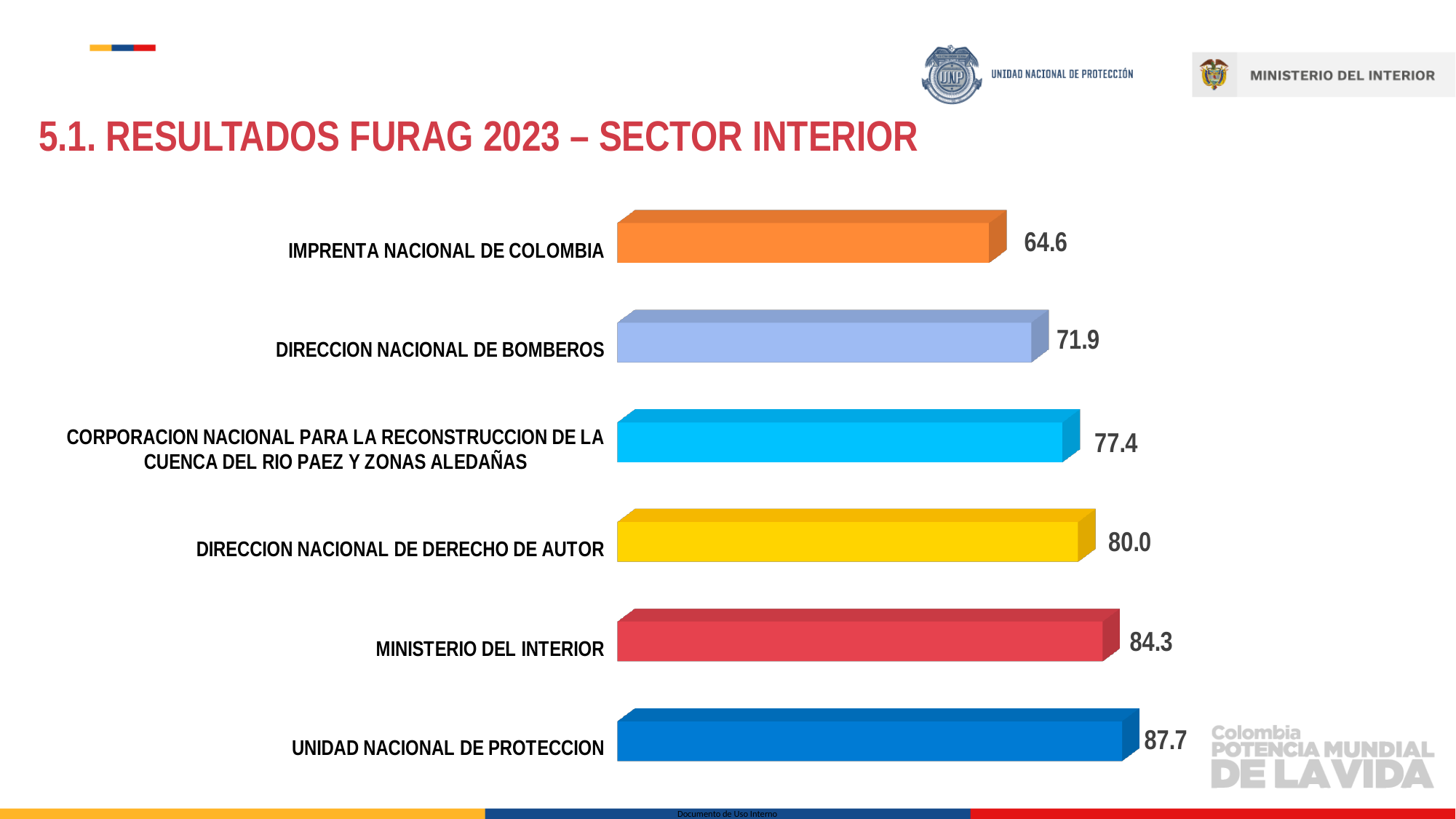
What is the value for CORPORACION NACIONAL PARA LA RECONSTRUCCION DE LA CUENCA DEL RIO PAEZ Y ZONAS ALEDAÑAS? 77.4 Which is larger, the value for MINISTERIO DEL INTERIOR or the value for DIRECCION NACIONAL DE DERECHO DE AUTOR? MINISTERIO DEL INTERIOR What colour is the bar for MINISTERIO DEL INTERIOR? Red Which entity has the lowest value? IMPRENTA NACIONAL DE COLOMBIA What is the value for UNIDAD NACIONAL DE PROTECCION? 87.7 What is the difference between the values for UNIDAD NACIONAL DE PROTECCION and IMPRENTA NACIONAL DE COLOMBIA? 23.1 What kind of chart is shown on the slide? Bar chart Which entity has the highest value? UNIDAD NACIONAL DE PROTECCION What is the value for IMPRENTA NACIONAL DE COLOMBIA? 64.6 What is the difference between the values for MINISTERIO DEL INTERIOR and DIRECCION NACIONAL DE BOMBEROS? 12.4 What is the value for DIRECCION NACIONAL DE DERECHO DE AUTOR? 80.0 How many entities are shown in the chart? 6